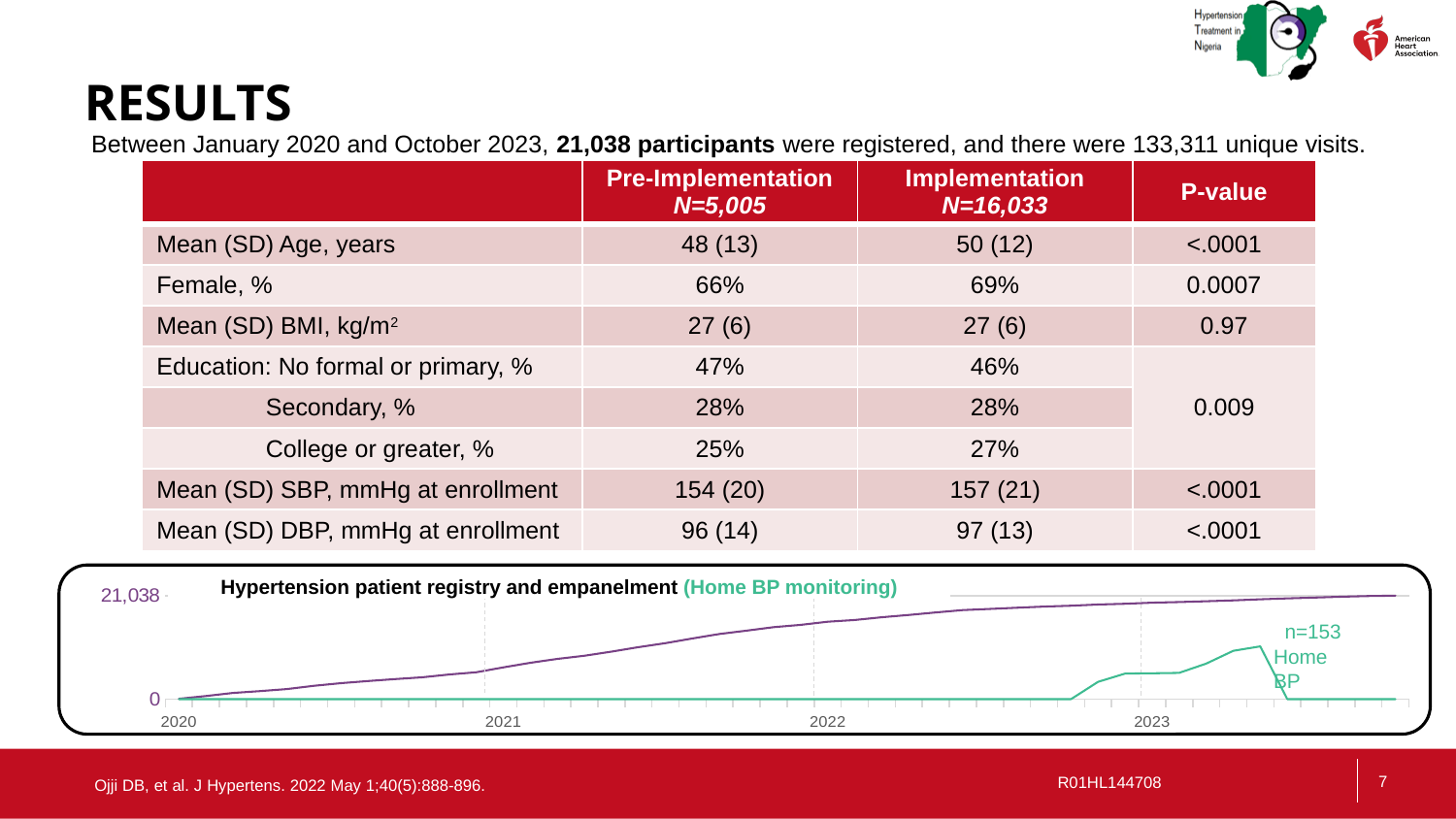
What is the title of the chart at the bottom of the slide? Hypertension patient registry and empanelment (Home BP monitoring) What kind of chart is shown at the bottom of the slide? line chart In the chart at the bottom of the slide, is the patient registry value at the start of 2022 greater or less than 21,038? less In the chart at the bottom of the slide, what is the value of the top tick on the y axis? 21,038 In the chart at the bottom of the slide, what is the first year label on the x axis? 2020 How many year labels are shown on the x axis of the chart at the bottom of the slide? 4 In the chart at the bottom of the slide, which line is higher at the end of 2023: the patient registry line or the Home BP line? the patient registry line In the chart at the bottom of the slide, what is the last year label on the x axis? 2023 In the chart at the bottom of the slide, what n value is labelled for Home BP? n=153 In the chart at the bottom of the slide, what colour is the Home BP line? green In the chart at the bottom of the slide, does the patient registry line rise or fall from 2020 to 2023? rise In the chart at the bottom of the slide, what is the value of the bottom tick on the y axis? 0